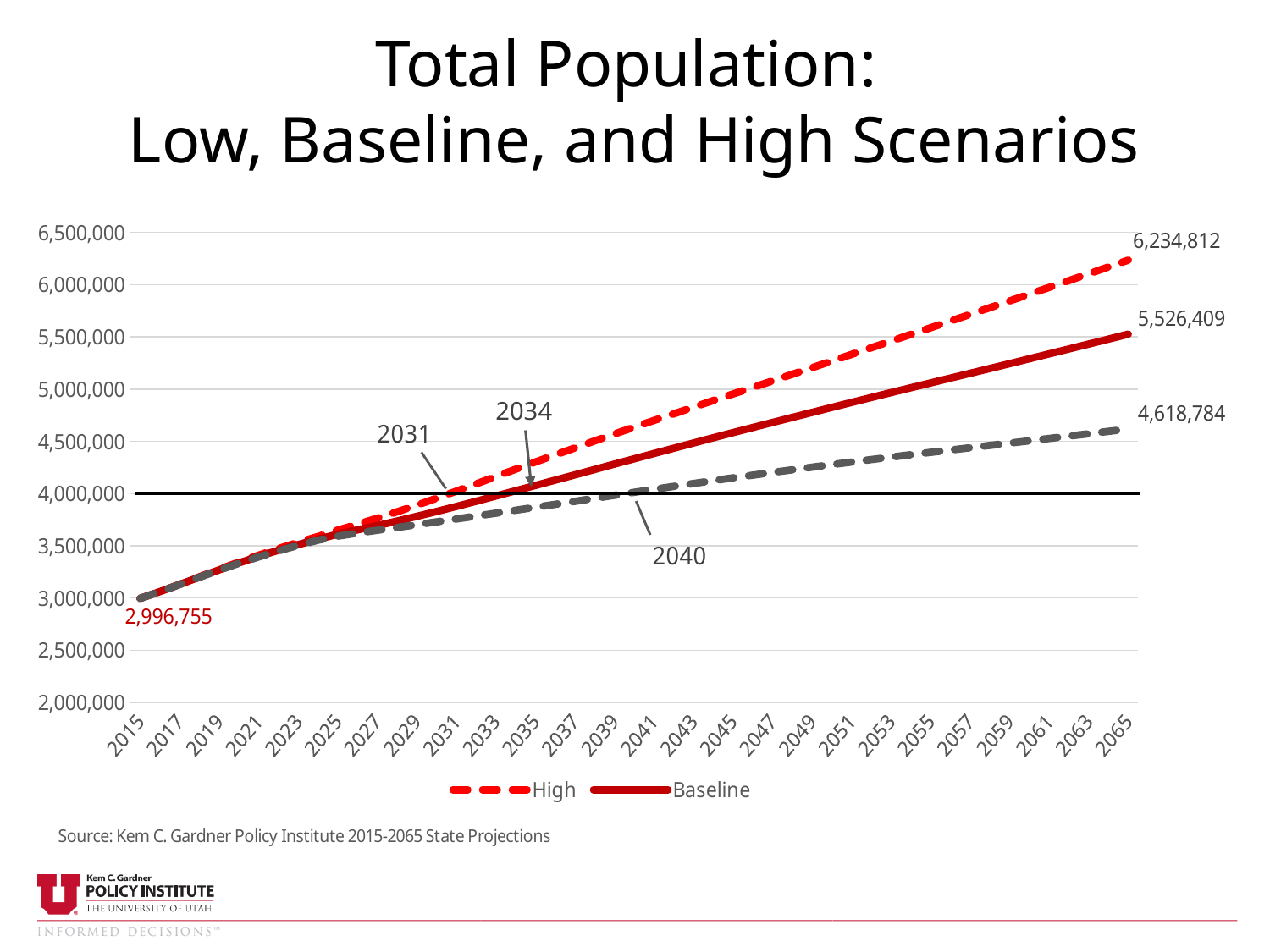
Which scenario has the highest value in 2065? High What kind of chart is shown on the slide? line chart Which year is annotated where the gray dashed line crosses the 4,000,000 reference line? 2040 What is the value of the Baseline scenario in 2065? 5,526,409 What is the value of the High scenario in 2065? 6,234,812 How many series does the legend list? 2 What is the difference between the High and Baseline values in 2065? 708,403 Do the population values rise or fall from 2015 to 2065? rise Is the Baseline value in 2050 greater or less than 4,500,000? greater What is the total population value labelled at the start of the chart in 2015? 2,996,755 What is the value labelled at the end of the lowest (gray dashed) line in 2065? 4,618,784 What is the difference between the Baseline value and the lowest line's value in 2065? 907,625